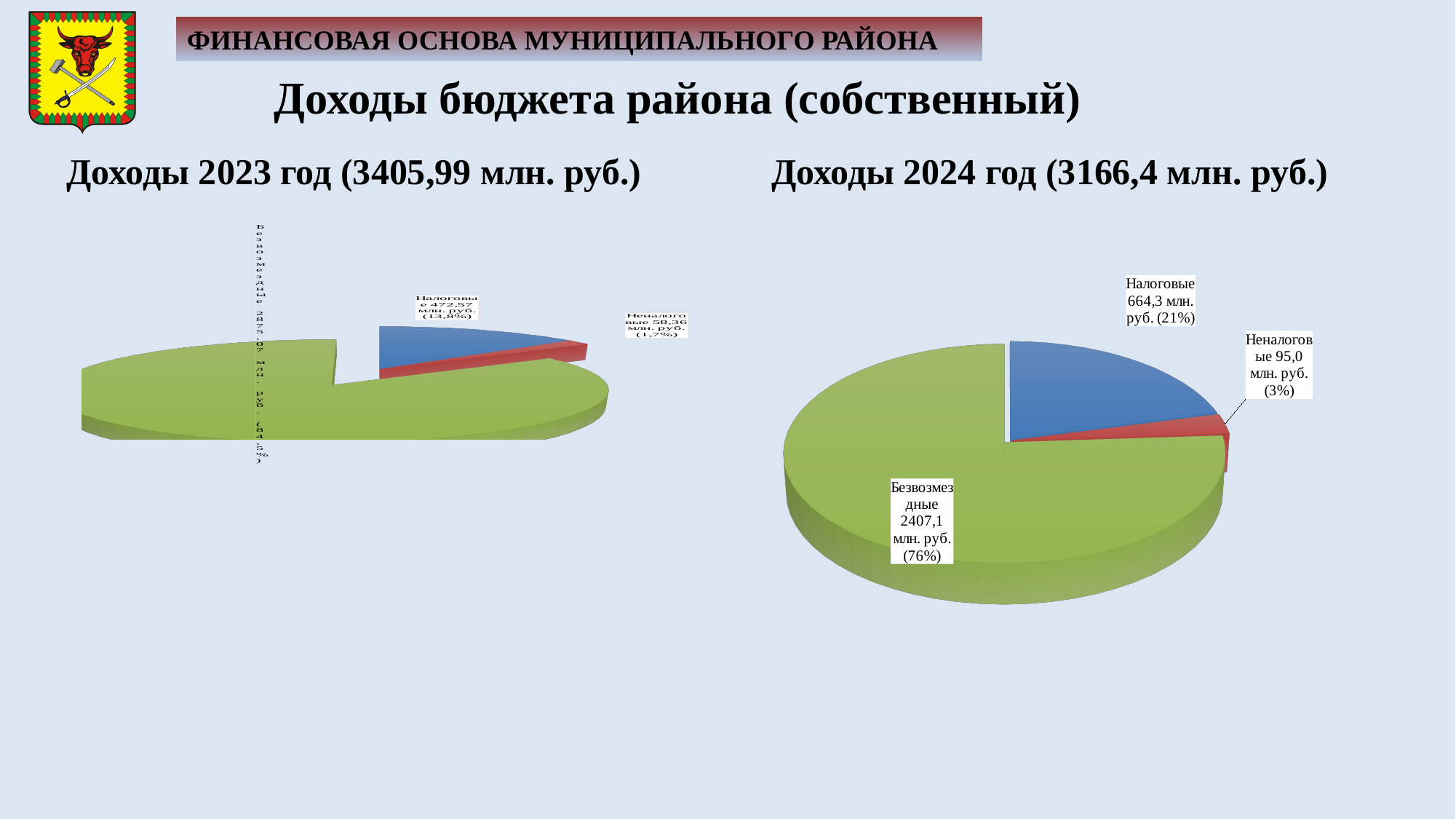
What kind of chart is used for 'Доходы 2024 год (3166,4 млн. руб.)'? Pie chart In the 'Доходы 2024 год' chart, which category is the smallest? Неналоговые In the 'Доходы 2024 год' chart, what colour is the Безвозмездные slice? Green In the 'Доходы 2023 год' chart, what is the value for Налоговые? 472,57 млн. руб. In the 'Доходы 2024 год' chart, what is the value for Налоговые? 664,3 млн. руб. In the 'Доходы 2024 год' chart, what is the difference between Налоговые and Неналоговые? 569,3 млн. руб. In the 'Доходы 2024 год' chart, which category is the largest? Безвозмездные In the 'Доходы 2024 год' chart, what is the value for Неналоговые? 95,0 млн. руб. In the 'Доходы 2023 год' chart, which is larger, Налоговые or Неналоговые? Налоговые In the 'Доходы 2023 год' chart, what share of the pie is Неналоговые? 1,7% In the 'Доходы 2024 год' chart, what share of the pie is Безвозмездные? 76% In the 'Доходы 2024 год' chart, how many slices does the pie have? 3